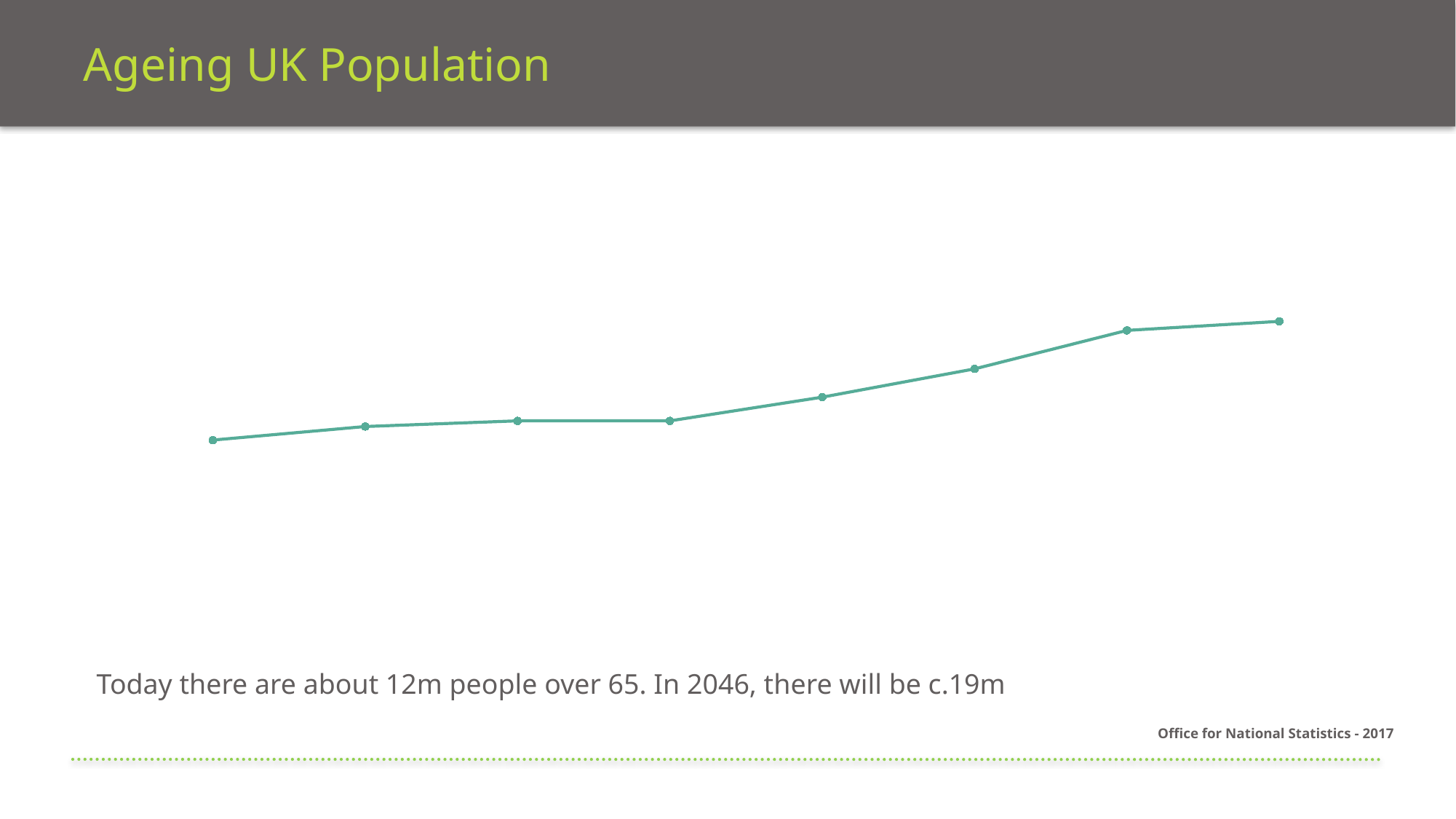
Is the rightmost point on the line higher or lower than the leftmost point? higher Do the plotted values rise or fall from left to right? rise What colour is the plotted line? green What is the title of the slide containing the chart? Ageing UK Population How many data points are plotted on the line? 8 What kind of chart is shown on the slide? line chart Is the highest point on the line at the left end or the right end of the chart? right end How many lines (series) are plotted on the chart? 1